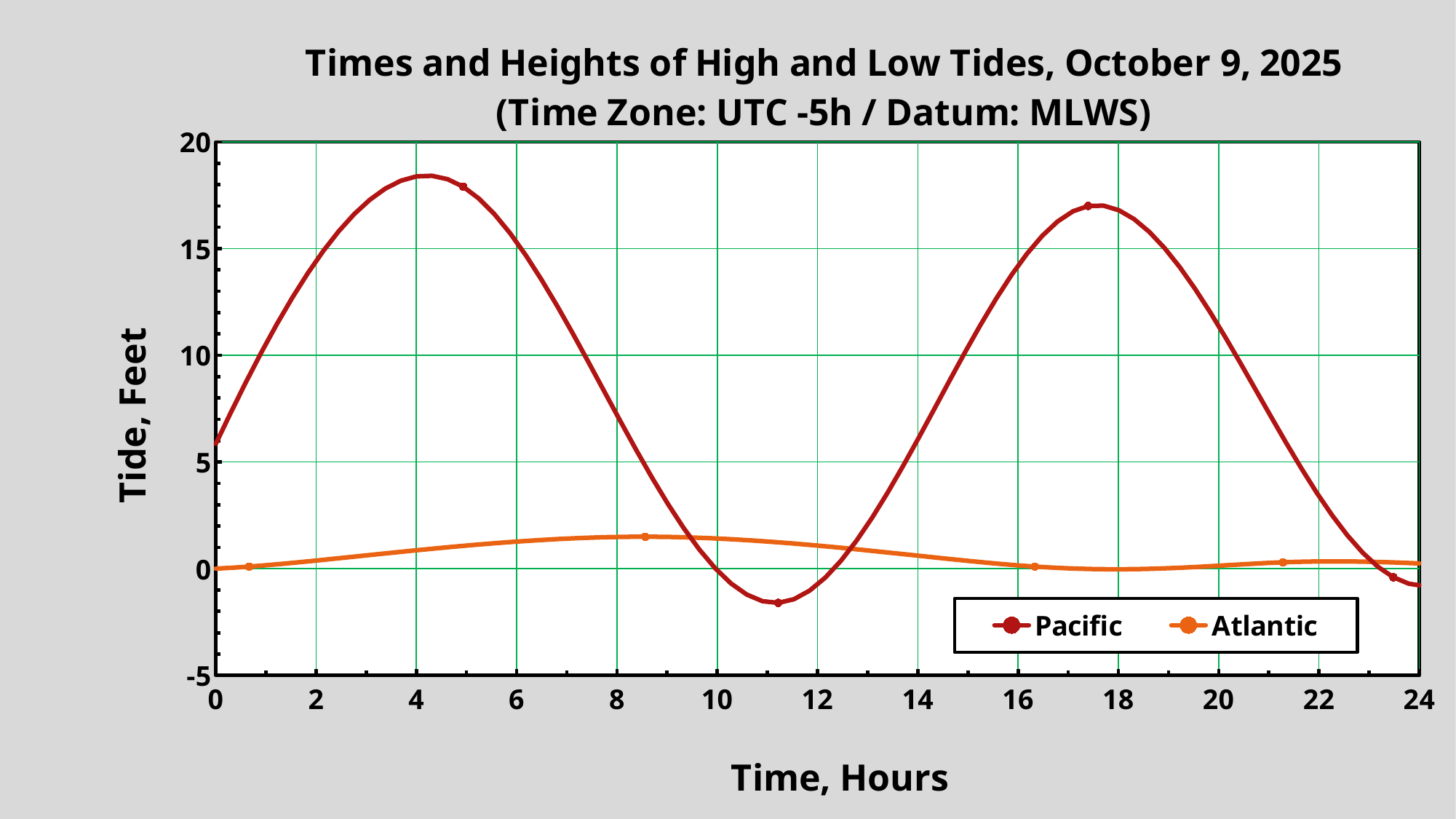
Does the Pacific tide rise or fall between hour 6 and hour 10? Fall Is the Pacific tide at hour 10 greater or less than 5 feet? less Is the Pacific tide at hour 18 greater or less than 15 feet? greater At hour 4, which series has the higher tide, Pacific or Atlantic? Pacific What is the label of the x axis? Time, Hours Is the Atlantic tide at hour 8 greater or less than 5 feet? less What kind of chart is shown on the slide? Line chart Which series reaches the highest tide value on the chart? Pacific At hour 12, which series has the higher tide, Pacific or Atlantic? Atlantic What is the label of the y axis? Tide, Feet How many series does the legend list? 2